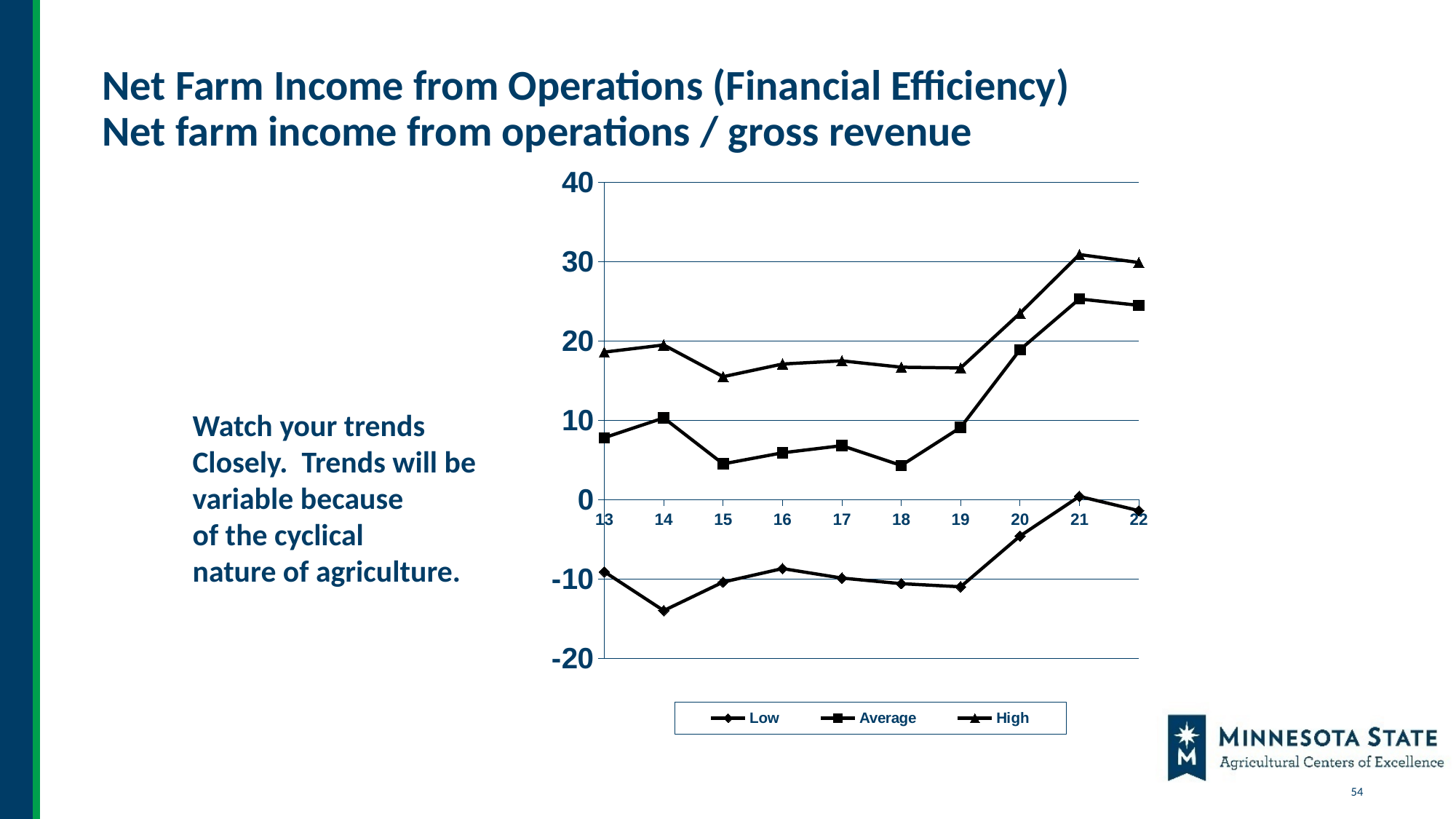
How many years are plotted along the x axis? 10 Does the Average series rise or fall from year 19 to year 21? rise Which is larger for the Average series: the value in year 19 or the value in year 20? year 20 Is the value for the Average series in year 18 greater or less than 10? less Which series are listed in the legend? Low, Average, High In which year does the High series reach its highest value? 21 Is the value for the High series in year 20 greater or less than 20? greater In which year does the Low series reach its lowest value? 14 Is the value for the Low series in year 14 greater or less than -10? less What kind of chart is shown on the slide? line chart How many series does the legend list? 3